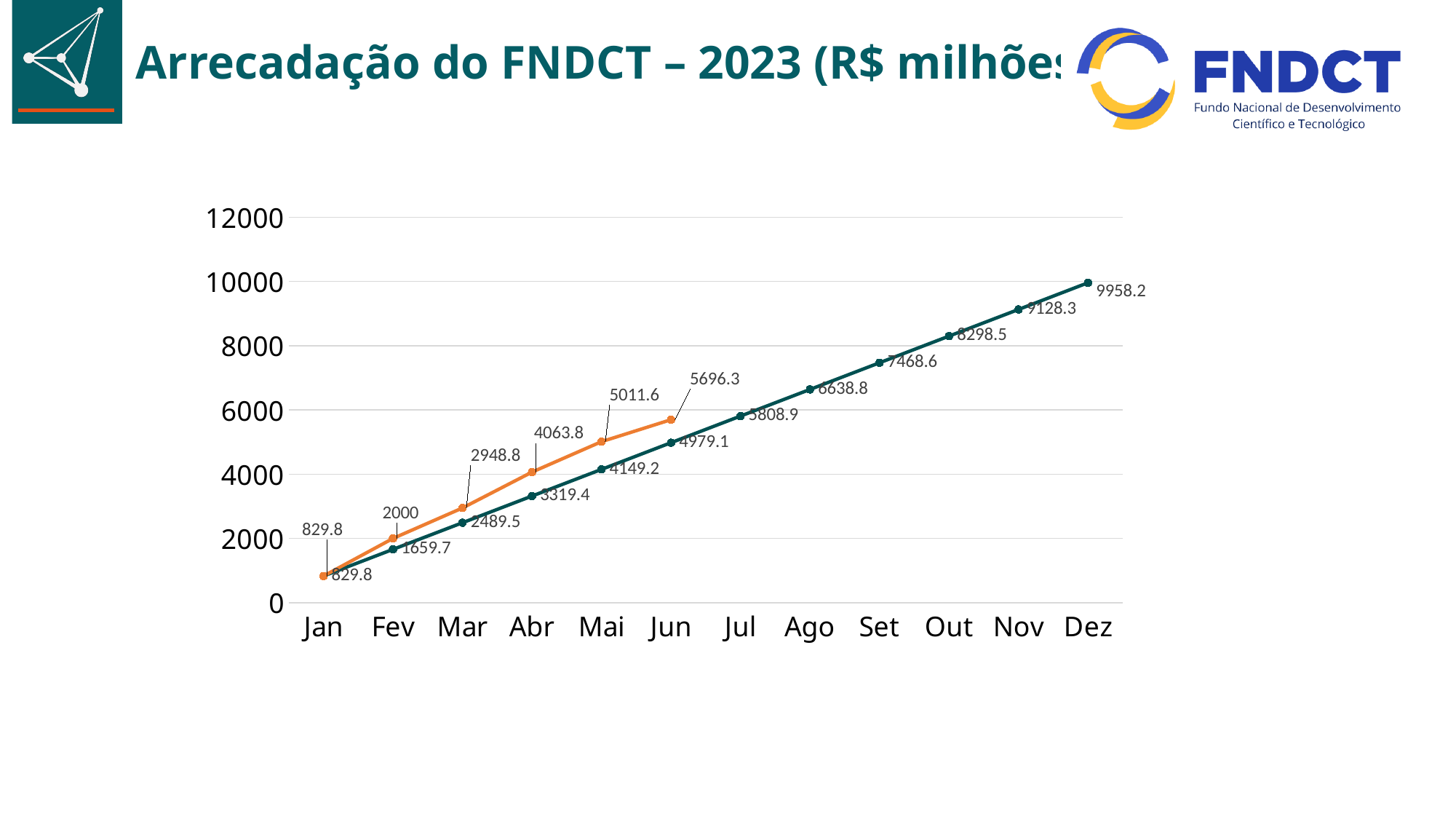
What kind of chart is shown on the slide? line chart What is the value of the orange line for Jun? 5696.3 Which line has the higher value in Mai, the orange line or the dark teal line? the orange line What is the difference between the orange line and the dark teal line in Jun? 717.2 How many months are shown on the x axis of the chart? 12 Does the dark teal line rise or fall from Jan to Dez? rise Up to which month does the orange line extend? Jun In which month does the dark teal line reach its highest value? Dez What is the value of the dark teal line for Dez? 9958.2 In which month does the orange line have its lowest value? Jan What is the value of the orange line for Fev? 2000 What is the value of the dark teal line for Jul? 5808.9